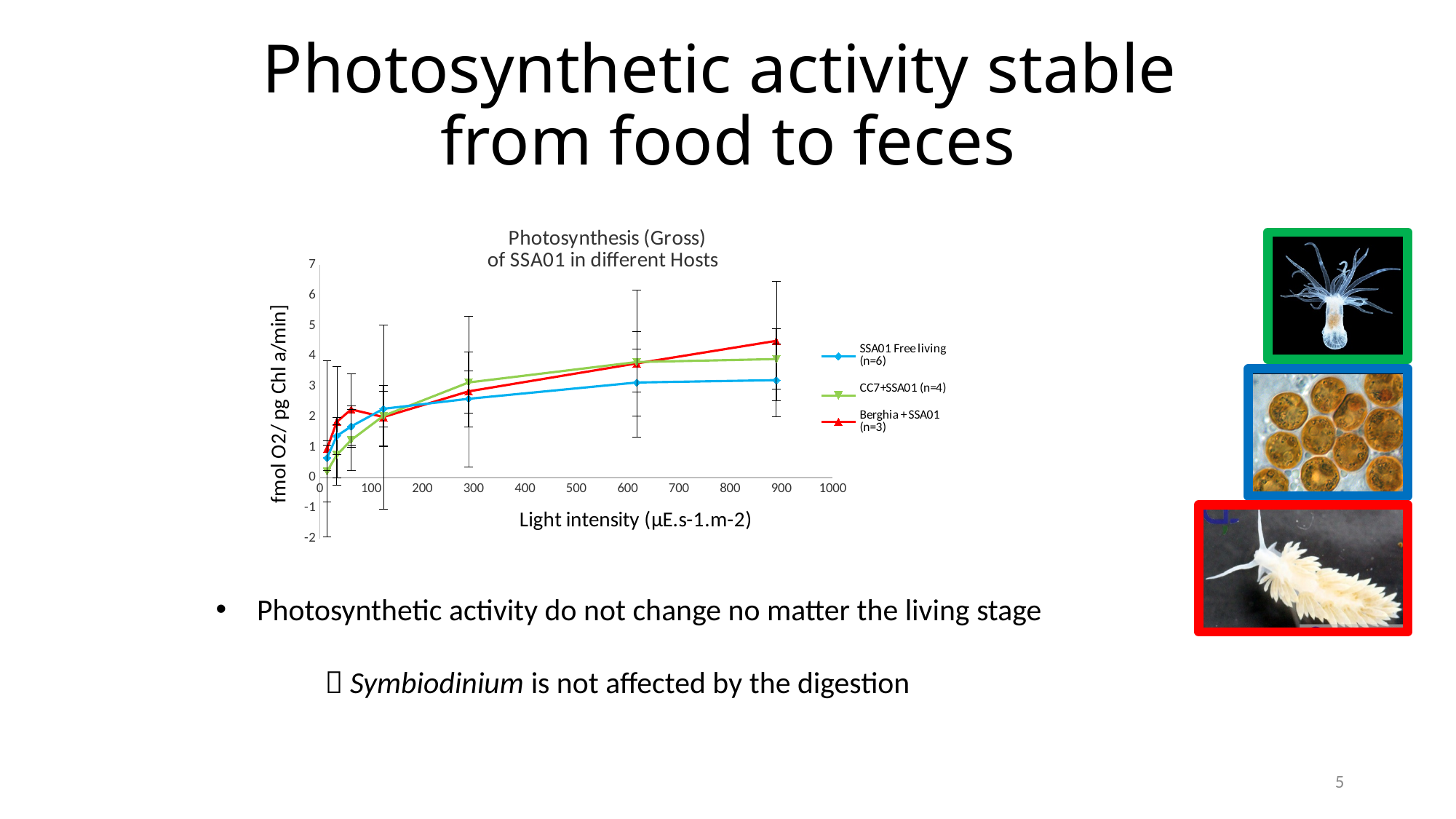
What is the title of the chart? Photosynthesis (Gross) of SSA01 in different Hosts How many series does the chart legend list? 3 Is the value for Berghia + SSA01 at the highest light intensity greater or less than 4? greater Is the value for CC7+SSA01 at the highest light intensity greater or less than 3? greater At the highest light intensity, which is larger: the value for Berghia + SSA01 or the value for SSA01 Free living? Berghia + SSA01 Which series has the lowest value at the highest light intensity (around 900)? SSA01 Free living (n=6) What kind of chart is shown on the slide? Line chart Which series has the highest value at the highest light intensity (around 900)? Berghia + SSA01 (n=3) Do the values for the series generally rise or fall as light intensity increases? Rise Is the value for SSA01 Free living at the highest light intensity greater or less than 4? less At a light intensity of about 300, which is larger: the value for CC7+SSA01 or the value for SSA01 Free living? CC7+SSA01 Which series is drawn in blue in the chart? SSA01 Free living (n=6)